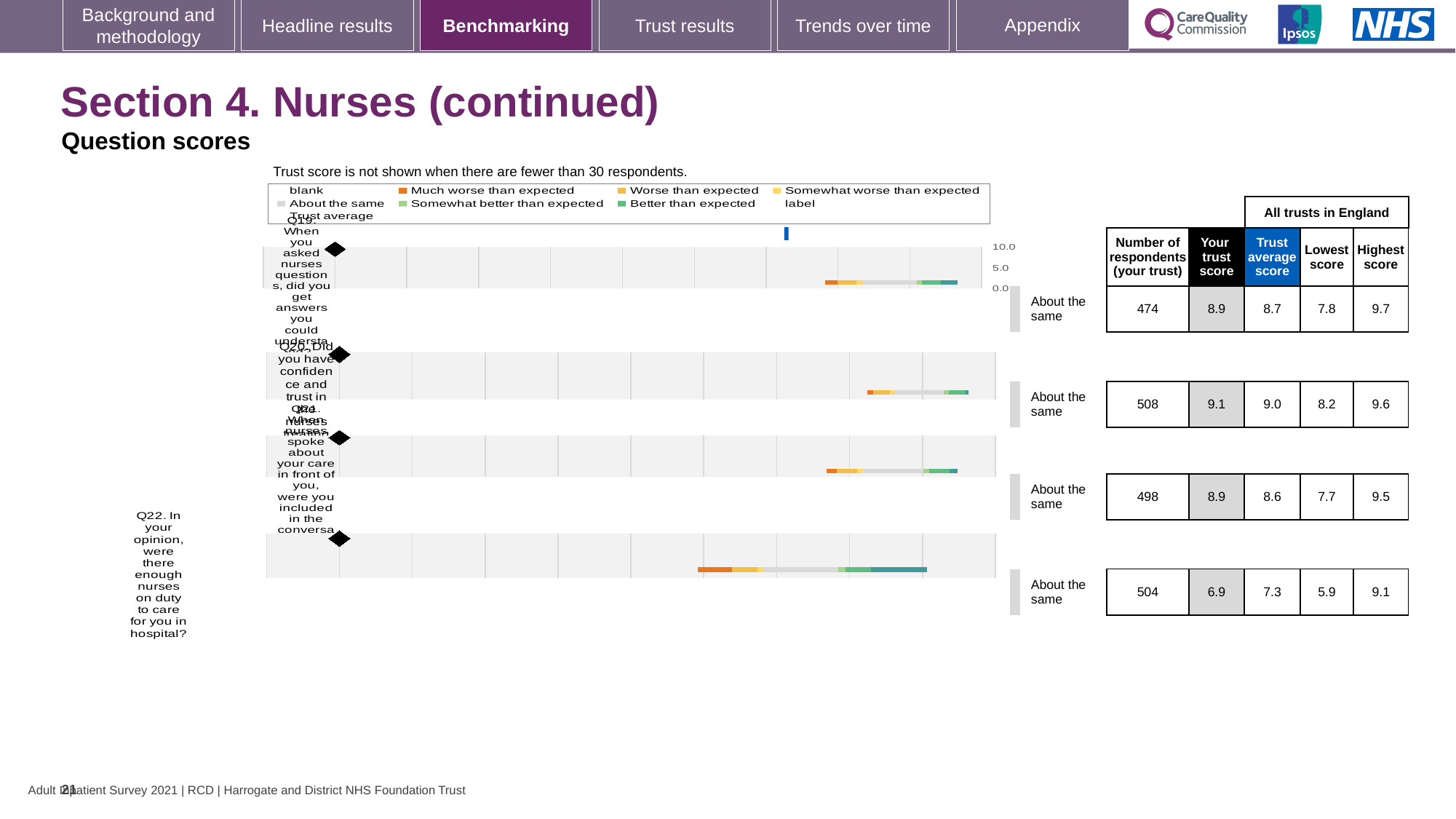
Which question has the lowest 'Your trust score'? Q22 What is the lowest score across all trusts in England for Q22? 5.9 What is your trust score for Q20 (confidence and trust in the nurses)? 9.1 What is the trust average score for Q22? 7.3 How many questions are plotted on the chart? 4 What benchmark category is shown for all four questions? About the same Which question has the highest 'Your trust score'? Q20 For Q22, what is the difference between the trust average score and your trust score? 0.4 What kind of chart is used to show the question scores? Bar chart For Q19, which is larger: your trust score or the trust average score? Your trust score How many respondents from your trust answered Q22 (were there enough nurses on duty)? 504 What is the highest score across all trusts in England for Q20? 9.6